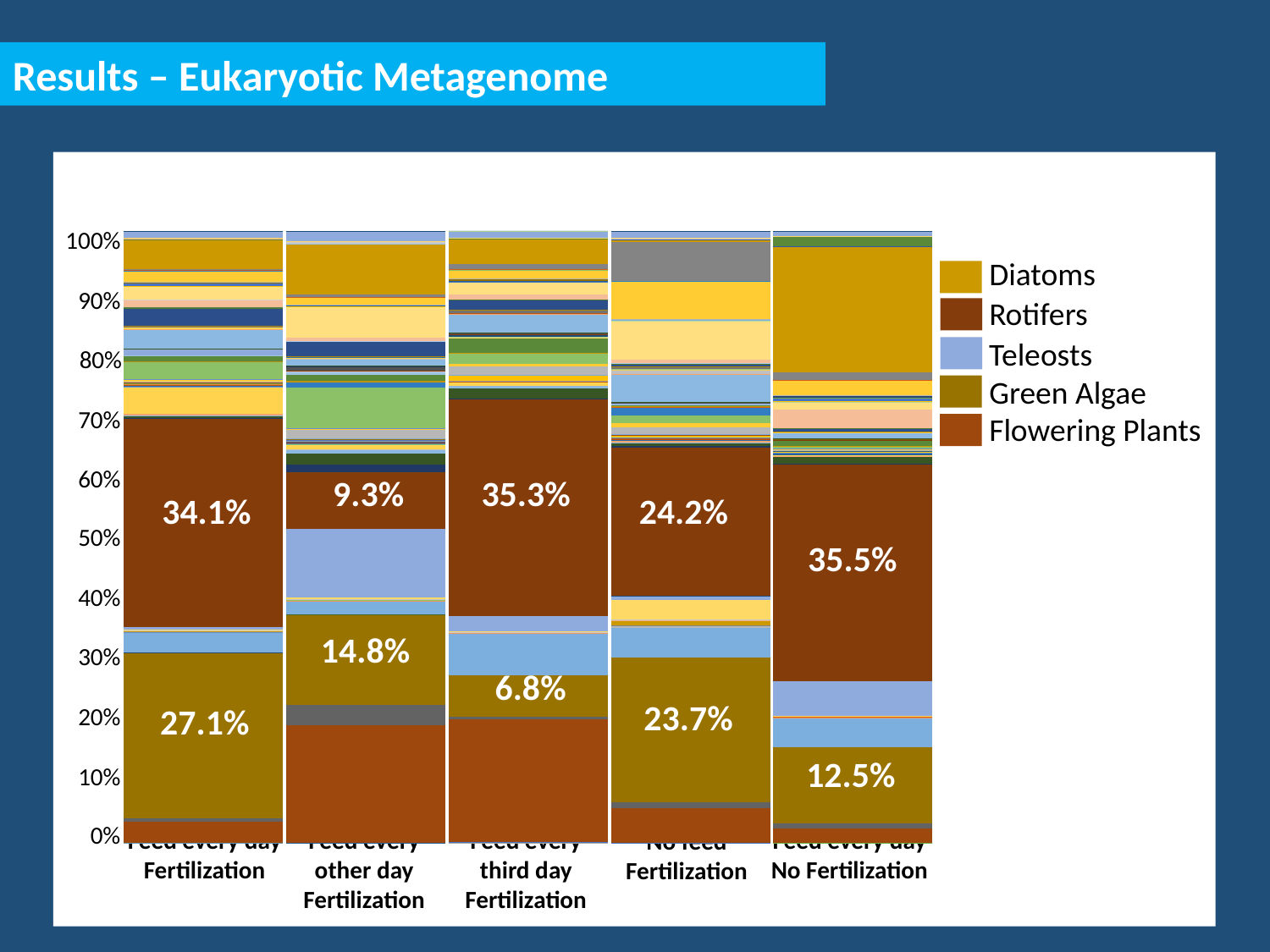
Which has a larger Green Algae share: No feed Fertilization or Feed every day No Fertilization? No feed Fertilization What percentage of the Feed every day Fertilization bar is Rotifers? 34.1% What type of chart is shown on the slide? Stacked bar chart What is the difference in Rotifers share between Feed every day Fertilization and No feed Fertilization? 9.9 percentage points What percentage of the Feed every other day Fertilization bar is Green Algae? 14.8% How many treatment bars are shown in the chart? 5 How many entries does the legend list? 5 Which treatment has the lowest labelled Rotifers share? Feed every other day Fertilization Which treatment has the highest labelled Rotifers share? Feed every day No Fertilization Is the Flowering Plants share in the Feed every third day Fertilization bar greater or less than 10%? greater Which treatment has the lowest labelled Green Algae share? Feed every third day Fertilization What is the labelled Rotifers share for the No feed Fertilization bar? 24.2%